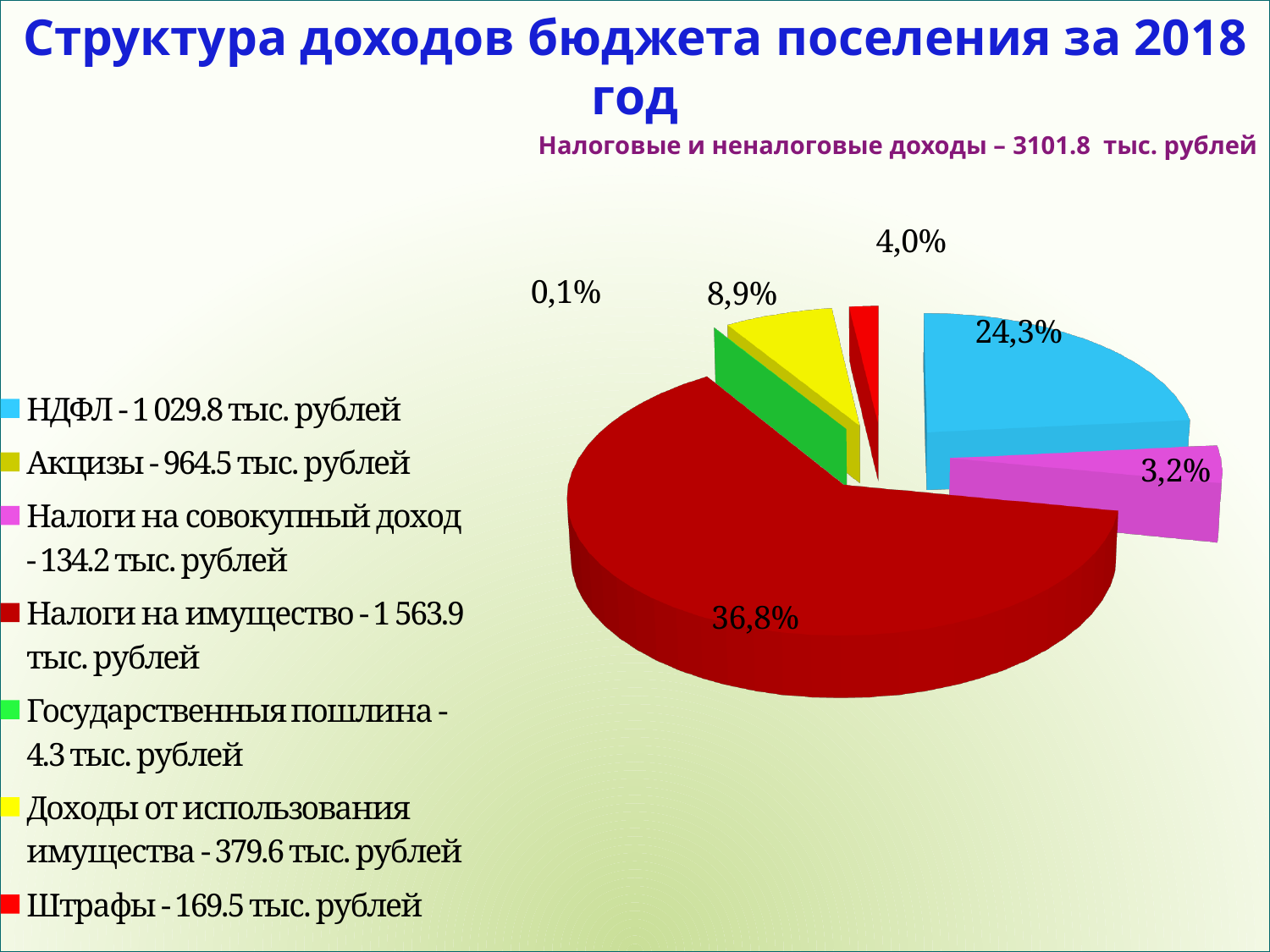
What share of the pie does Государственная пошлина (the green slice) represent? 0,1% What share of the pie does Штрафы (the red slice) represent? 4,0% Which category has the largest slice of the pie? Налоги на имущество Which slice is larger: НДФЛ or Доходы от использования имущества? НДФЛ According to the legend, what is the amount for НДФЛ? 1 029.8 тыс. рублей Which category has the smallest slice of the pie? Государственная пошлина What share of the pie does Доходы от использования имущества (the yellow slice) represent? 8,9% How many categories does the legend list? 7 What kind of chart is shown on the slide? pie chart